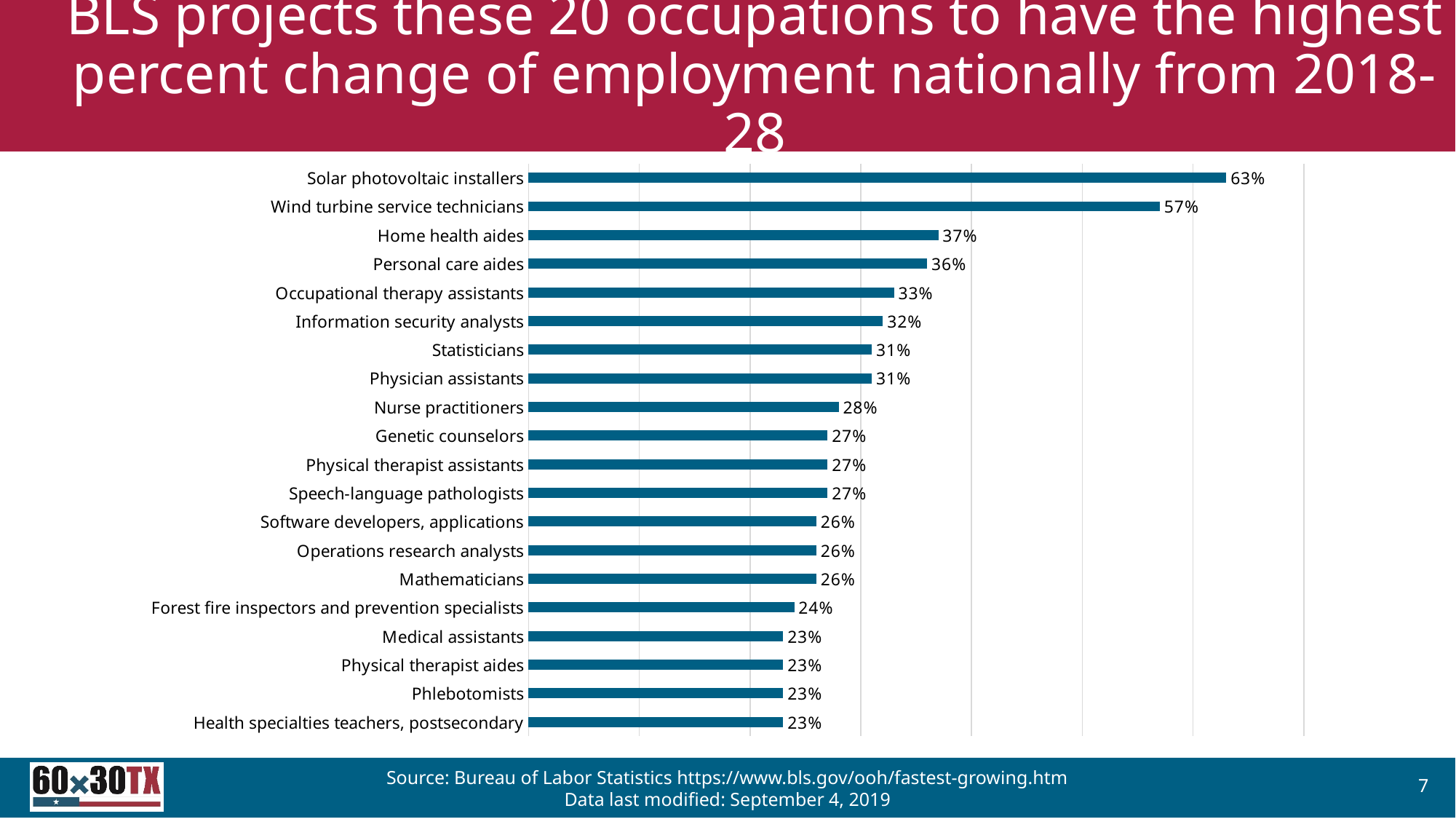
What is the projected percent change for Solar photovoltaic installers? 63% What is the projected percent change for Forest fire inspectors and prevention specialists? 24% Which occupation has the highest projected percent change? Solar photovoltaic installers What is the projected percent change for Phlebotomists? 23% What is the difference in projected percent change between Solar photovoltaic installers and Wind turbine service technicians? 6% What is the projected percent change for Information security analysts? 32% What source is cited for the chart data? Bureau of Labor Statistics Which has a larger projected percent change, Occupational therapy assistants or Statisticians? Occupational therapy assistants How many occupations are shown in the chart? 20 What is the difference in projected percent change between Home health aides and Nurse practitioners? 9% Which has a larger projected percent change, Medical assistants or Mathematicians? Mathematicians What kind of chart is shown on the slide? Bar chart